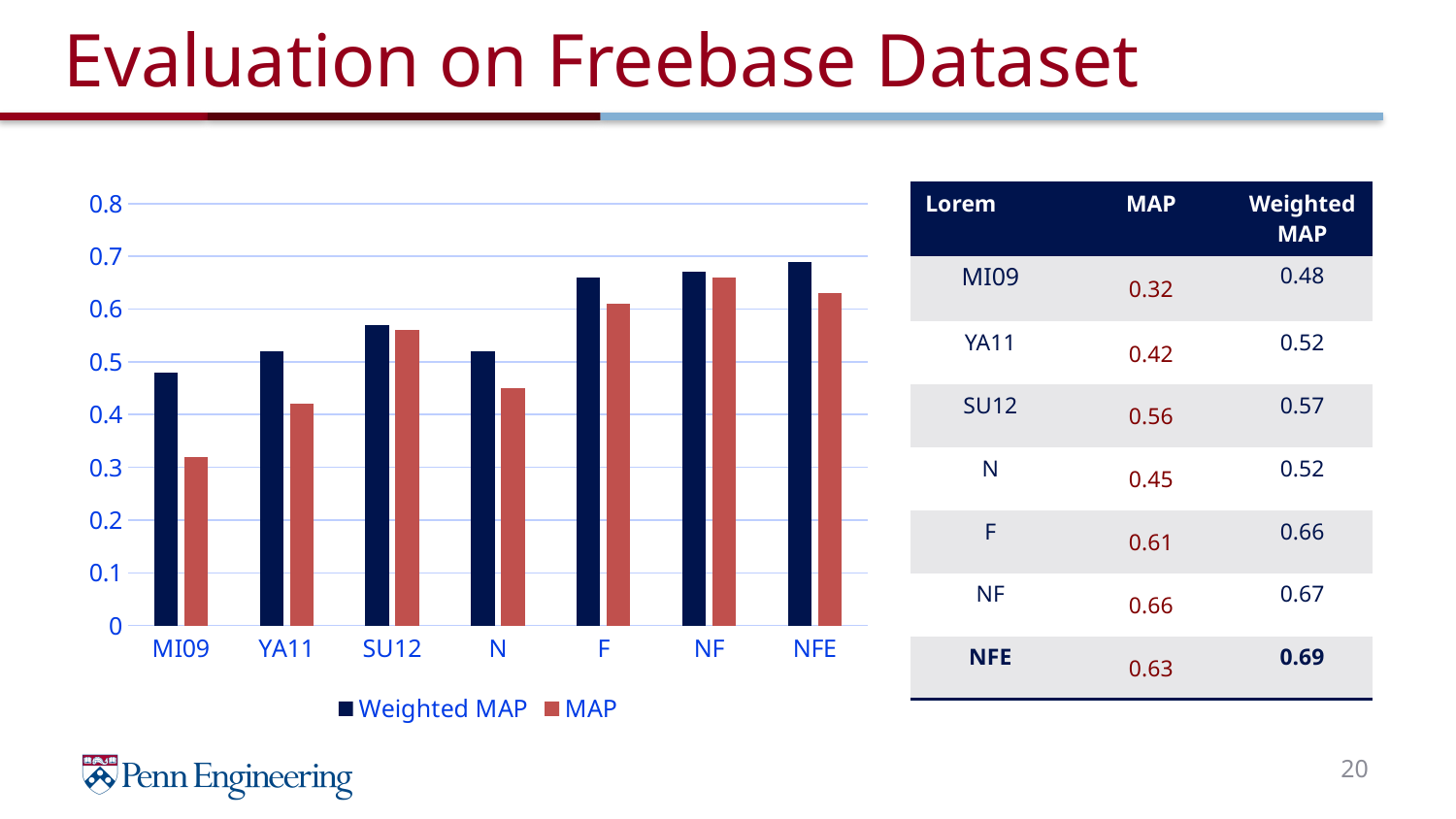
Which category has the lowest MAP bar? MI09 Which category has the highest Weighted MAP bar? NFE What type of chart is shown on the slide? bar chart What are the two series named in the chart legend? Weighted MAP and MAP What is the Weighted MAP value for NFE, as printed in the table on the slide? 0.69 Is the MAP value for MI09 greater or less than 0.4? less Using the values printed in the table, what is the difference between Weighted MAP and MAP for MI09? 0.16 How many series does the chart legend list? 2 Which category has the highest MAP bar? NF Is the Weighted MAP value for NFE greater or less than 0.6? greater For MI09, which is larger: Weighted MAP or MAP? Weighted MAP How many categories are shown on the x axis of the chart? 7